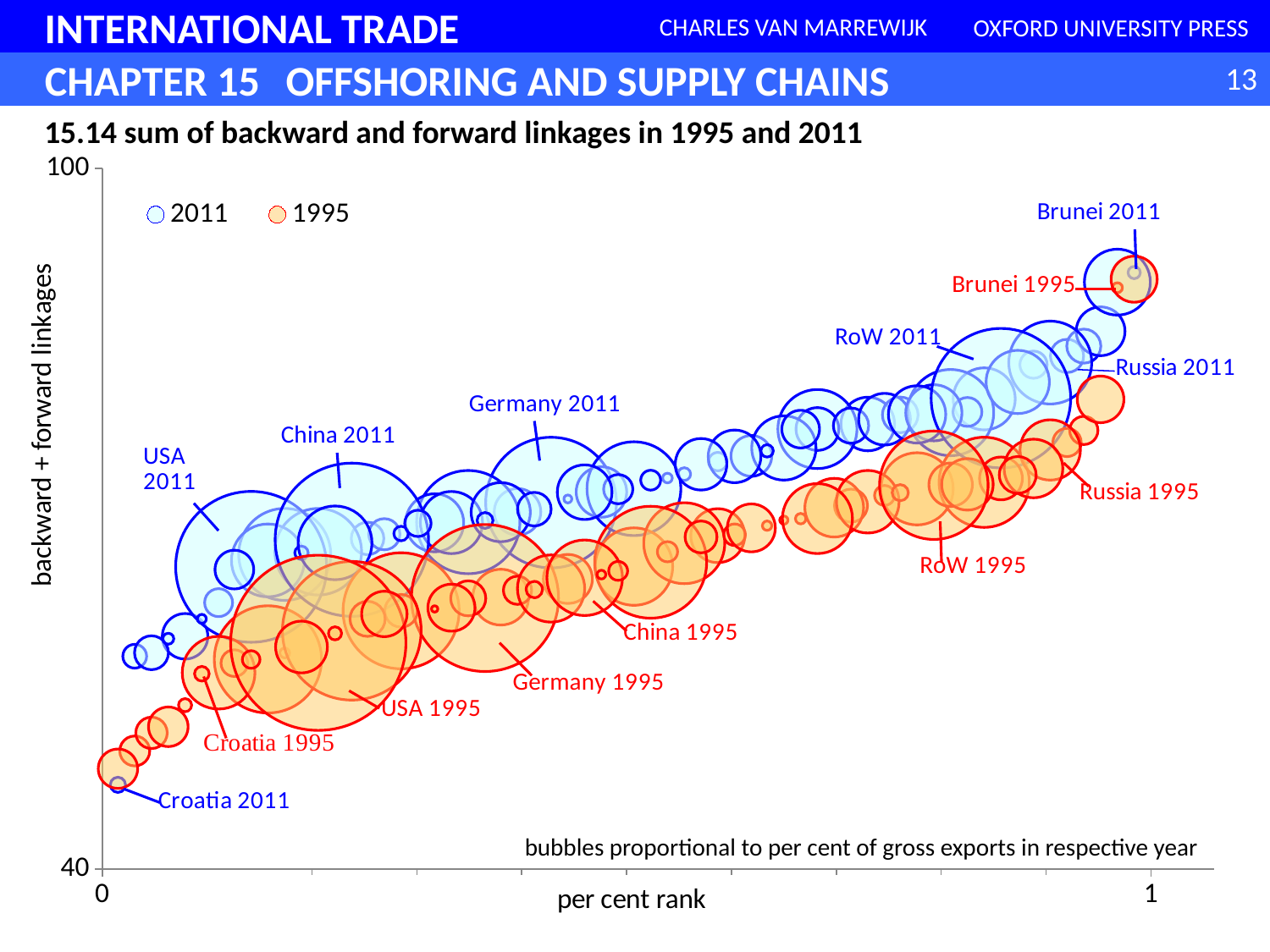
Which has the higher backward + forward linkages value, Brunei 2011 or Croatia 2011? Brunei 2011 What is the title of the chart? 15.14 sum of backward and forward linkages in 1995 and 2011 Which has the higher backward + forward linkages value, Germany 2011 or Germany 1995? Germany 2011 Is the backward + forward linkages value for Brunei 2011 greater or less than 100? less Which has the higher backward + forward linkages value, Russia 2011 or Russia 1995? Russia 2011 Which labelled bubble has the lowest backward + forward linkages value? Croatia 2011 How many series does the legend list? 2 Do the backward + forward linkages values rise or fall as per cent rank increases along the x axis? rise What are the bubble sizes proportional to, according to the note on the chart? per cent of gross exports in respective year What kind of chart is shown on the slide? bubble chart Which labelled bubble has the highest backward + forward linkages value? Brunei 2011